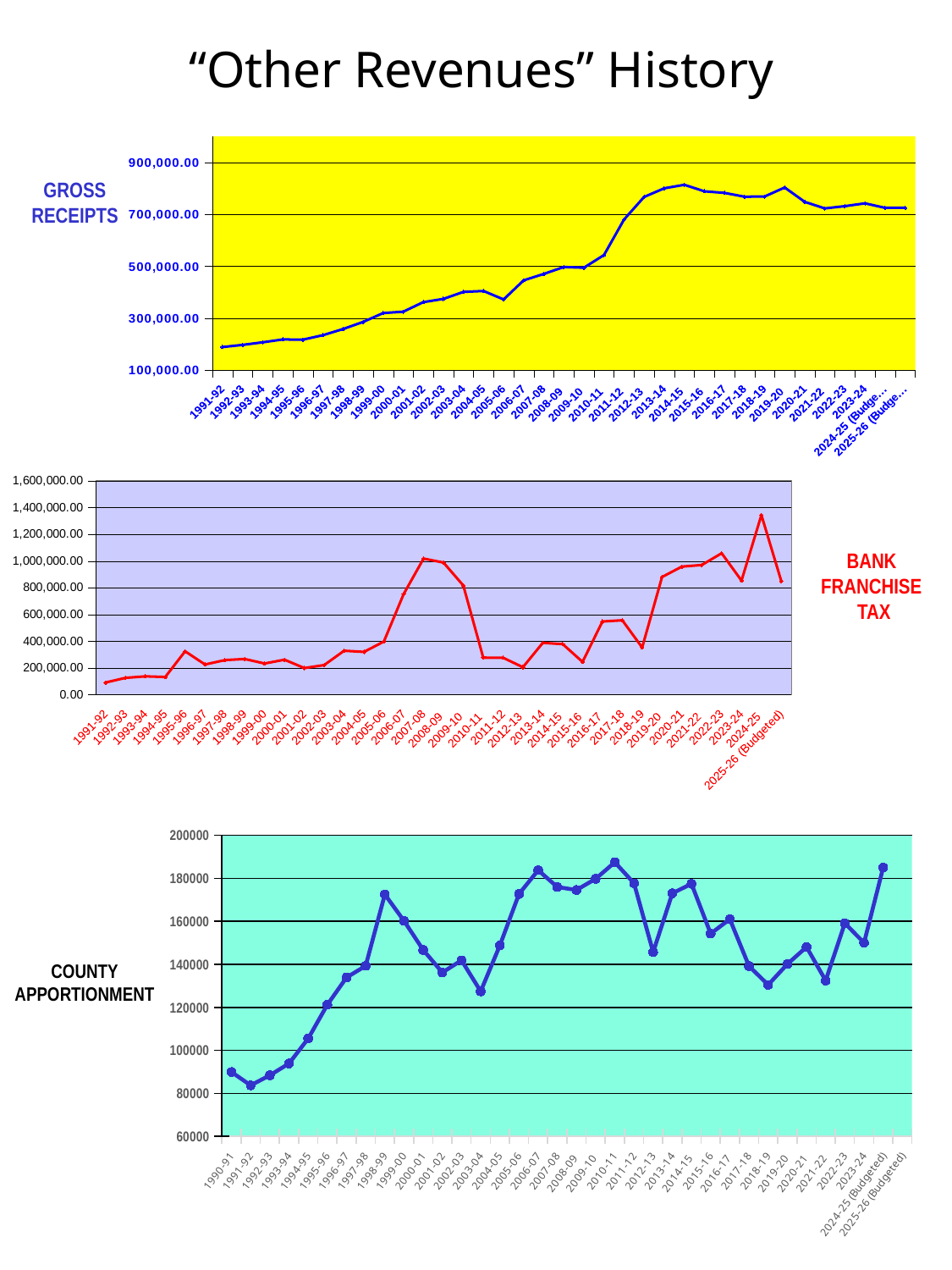
In the Bank Franchise Tax chart, which is larger, the value for 2007-08 or the value for 2012-13? 2007-08 In the Bank Franchise Tax chart, which year has the lowest value? 1991-92 In the County Apportionment chart, is the value for 2018-19 greater or less than 140000? less How many years are plotted in the County Apportionment chart? 35 In the County Apportionment chart, which year has the lowest value? 1991-92 In the Bank Franchise Tax chart, is the value for 2012-13 greater or less than 400,000.00? less In the Gross Receipts chart, is the value for 2007-08 greater or less than 300,000.00? greater In the Gross Receipts chart, which year has the lowest value? 1991-92 What kind of chart is the Gross Receipts chart? line chart In the Bank Franchise Tax chart, which year has the highest value? 2024-25 In the Gross Receipts chart, which is larger, the value for 2013-14 or the value for 2005-06? 2013-14